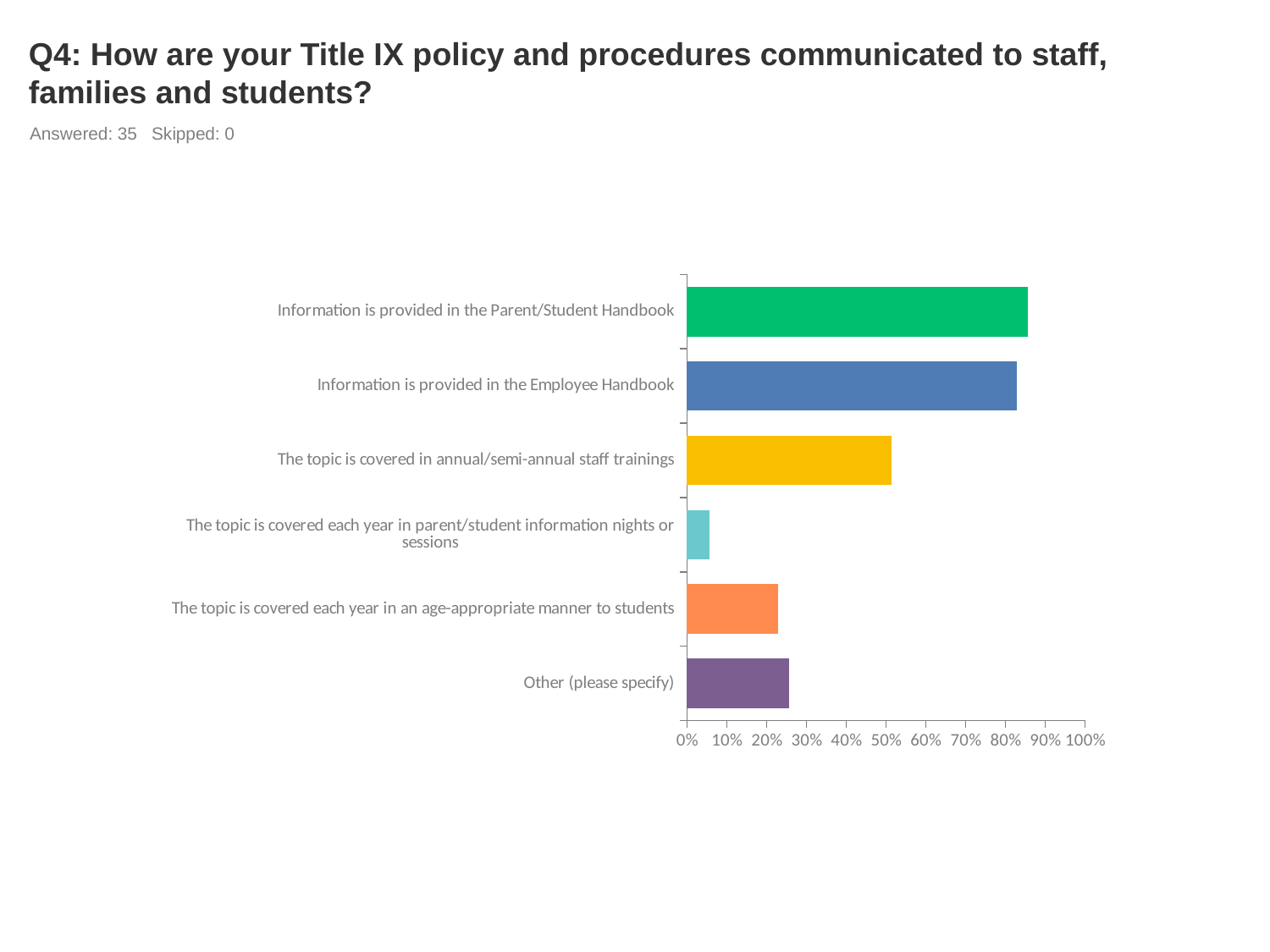
Is the value for "Information is provided in the Employee Handbook" greater or less than 70%? greater According to the slide, how many respondents answered this question? 35 Is the value for "The topic is covered each year in an age-appropriate manner to students" greater or less than 30%? less Is the value for "The topic is covered each year in parent/student information nights or sessions" greater or less than 10%? less Which category has the lowest value in the chart? The topic is covered each year in parent/student information nights or sessions Which is larger: the value for "Other (please specify)" or the value for "The topic is covered each year in parent/student information nights or sessions"? Other (please specify) Which is larger: the value for "The topic is covered in annual/semi-annual staff trainings" or the value for "The topic is covered each year in an age-appropriate manner to students"? The topic is covered in annual/semi-annual staff trainings What kind of chart is shown on the slide? bar chart How many categories (response options) are plotted in the chart? 6